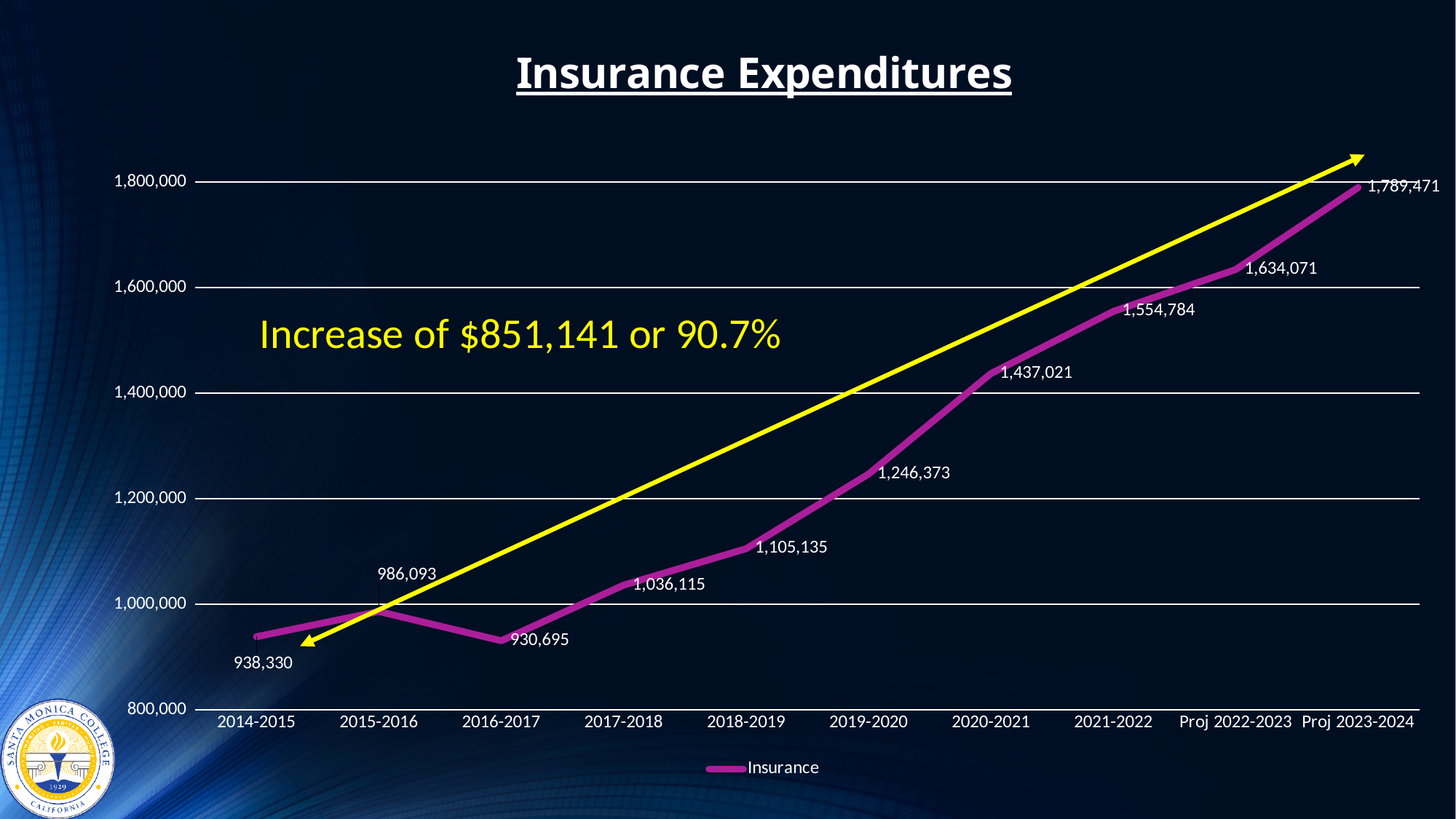
Is the Insurance value for 2021-2022 greater or less than 1,400,000? greater What is the Insurance value for 2014-2015? 938,330 What is the Insurance value for Proj 2023-2024? 1,789,471 Which period has the lowest Insurance value? 2016-2017 What is the difference between the Insurance values for 2020-2021 and 2019-2020? 190,648 Which is larger, the Insurance value for 2015-2016 or for 2016-2017? 2015-2016 Which period has the highest Insurance value? Proj 2023-2024 What is the difference between the Insurance values for Proj 2023-2024 and 2014-2015? 851,141 What is the title of the chart? Insurance Expenditures How many periods are shown on the x axis? 10 What kind of chart is shown on the slide? line chart What is the Insurance value for 2019-2020? 1,246,373